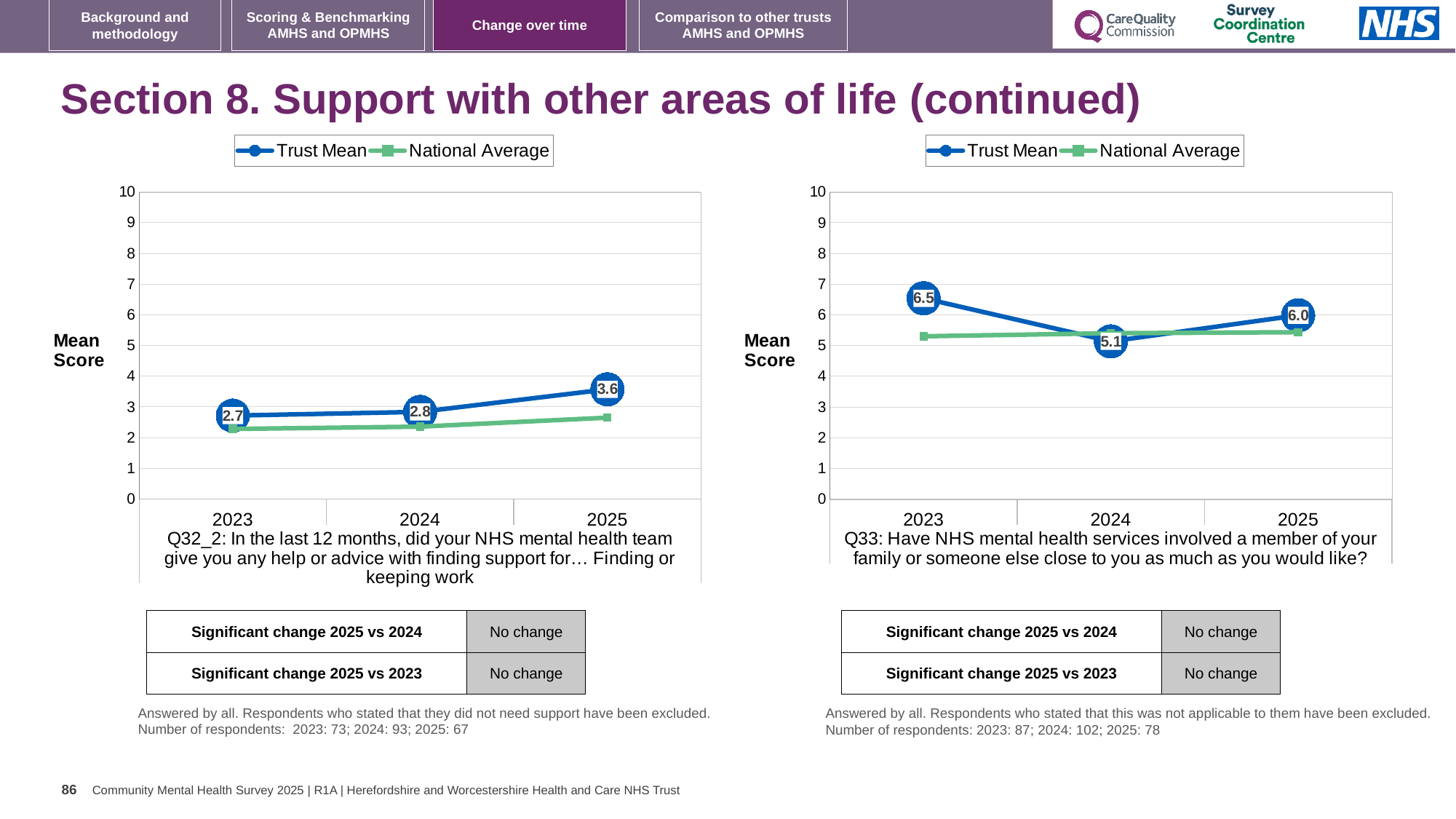
In the right chart (Q33), what is the Trust Mean for 2024? 5.1 In the right chart (Q33), is the Trust Mean for 2025 greater or less than the Trust Mean for 2024? greater In the left chart (Q32_2), what is the Trust Mean for 2025? 3.6 In the right chart (Q33), what is the difference between the Trust Mean for 2023 and 2024? 1.4 In the right chart (Q33), what is the Trust Mean for 2023? 6.5 In the left chart (Q32_2), what is the difference between the Trust Mean for 2025 and 2024? 0.8 In the right chart (Q33), which year has the highest Trust Mean? 2023 In the left chart (Q32_2), what is the Trust Mean for 2023? 2.7 In the left chart (Q32_2), which year has the lowest Trust Mean? 2023 How many series does the legend of the left chart (Q32_2) list? 2 In the left chart (Q32_2), is the National Average for 2025 greater or less than 3? less What kind of chart is the right chart (Q33)? Line chart